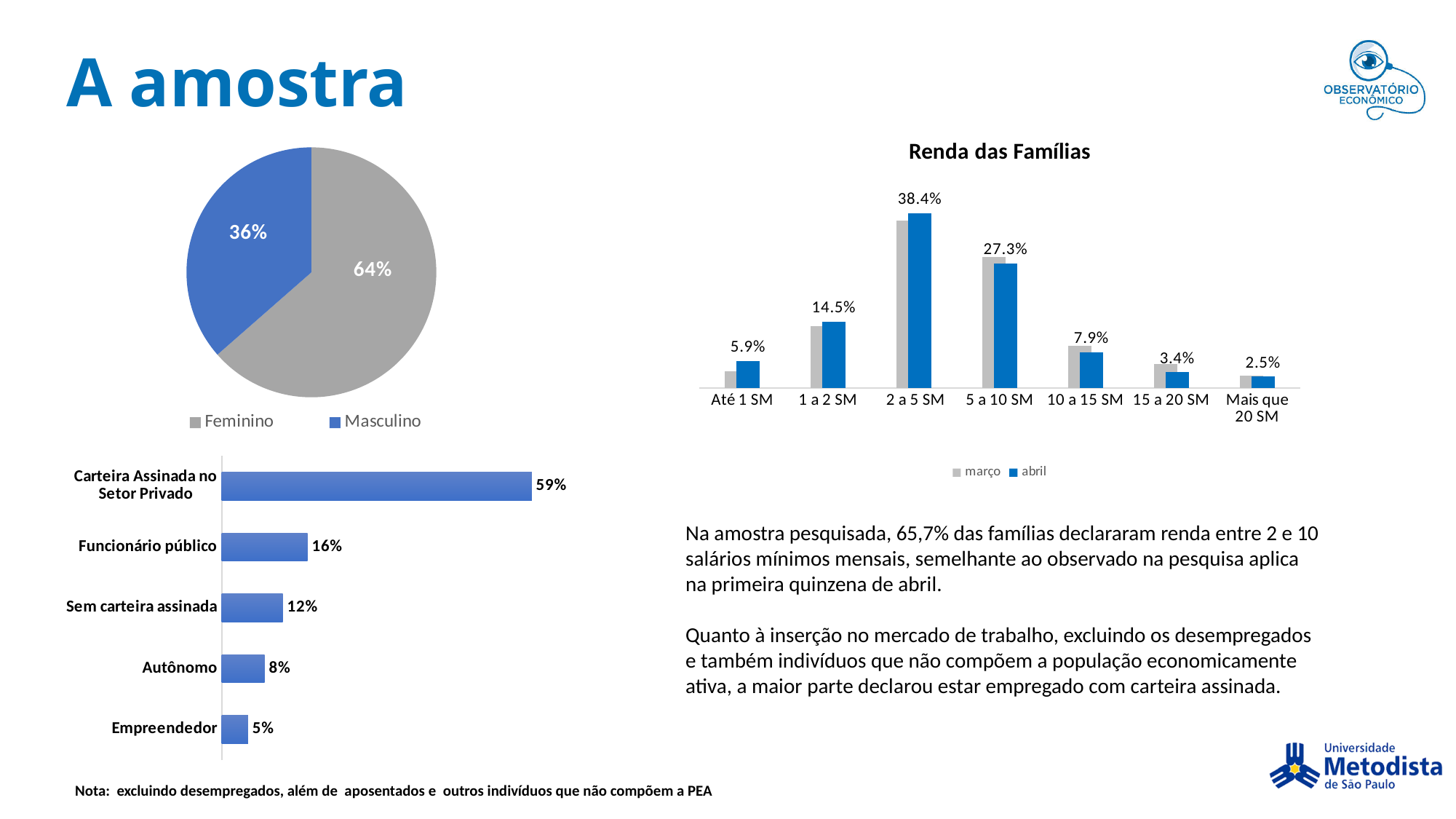
What kind of chart is Renda das Famílias? Bar chart In the horizontal bar chart at the bottom left, which category has the lowest value? Empreendedor In the pie chart, which slice is larger, Feminino or Masculino? Feminino In the pie chart, what share is Feminino? 64% In the Renda das Famílias chart, which income category has the highest values? 2 a 5 SM In the Renda das Famílias chart, how many income categories are shown on the x axis? 7 In the horizontal bar chart at the bottom left, what is the value for Carteira Assinada no Setor Privado? 59% In the Renda das Famílias chart, how many series does the legend list? 2 In the horizontal bar chart at the bottom left, what is the value for Funcionário público? 16% In the pie chart, what share is Masculino? 36% In the horizontal bar chart at the bottom left, what is the difference between Sem carteira assinada and Autônomo? 4% In the horizontal bar chart at the bottom left, how many categories are shown? 5